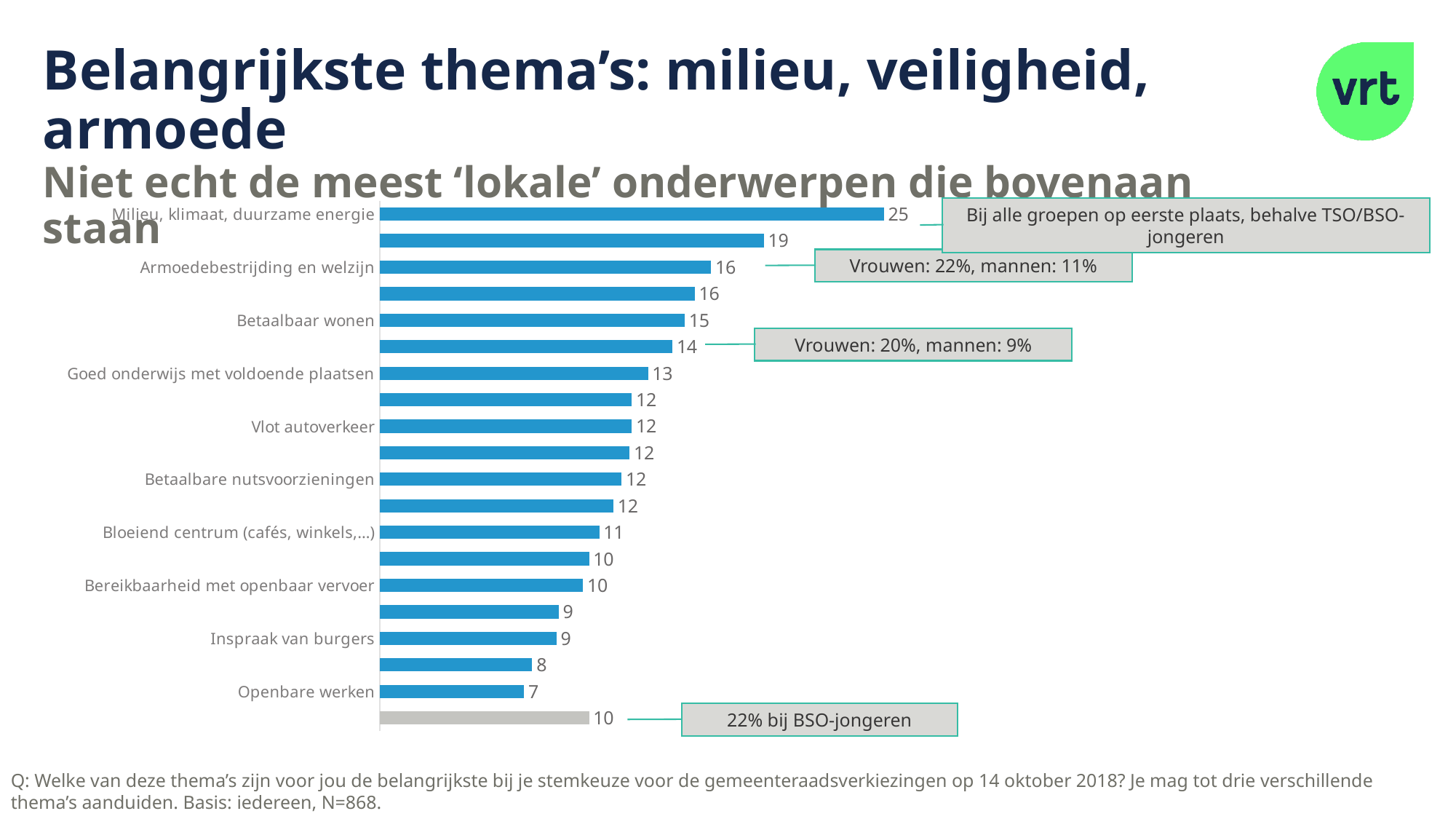
Which is larger: the value for 'Betaalbaar wonen' or for 'Bereikbaarheid met openbaar vervoer'? Betaalbaar wonen What is the value for 'Goed onderwijs met voldoende plaatsen'? 13 How many bars are plotted in the chart? 20 What is the value for 'Betaalbaar wonen'? 15 What is the difference between the values for 'Milieu, klimaat, duurzame energie' and 'Armoedebestrijding en welzijn'? 9 What is the value for 'Openbare werken'? 7 What type of chart is shown on the slide? bar chart What value is shown on the grey bar at the bottom of the chart? 10 What is the value for 'Milieu, klimaat, duurzame energie'? 25 Which category has the lowest value in the chart? Openbare werken What is the value for 'Armoedebestrijding en welzijn'? 16 Which category has the highest value in the chart? Milieu, klimaat, duurzame energie